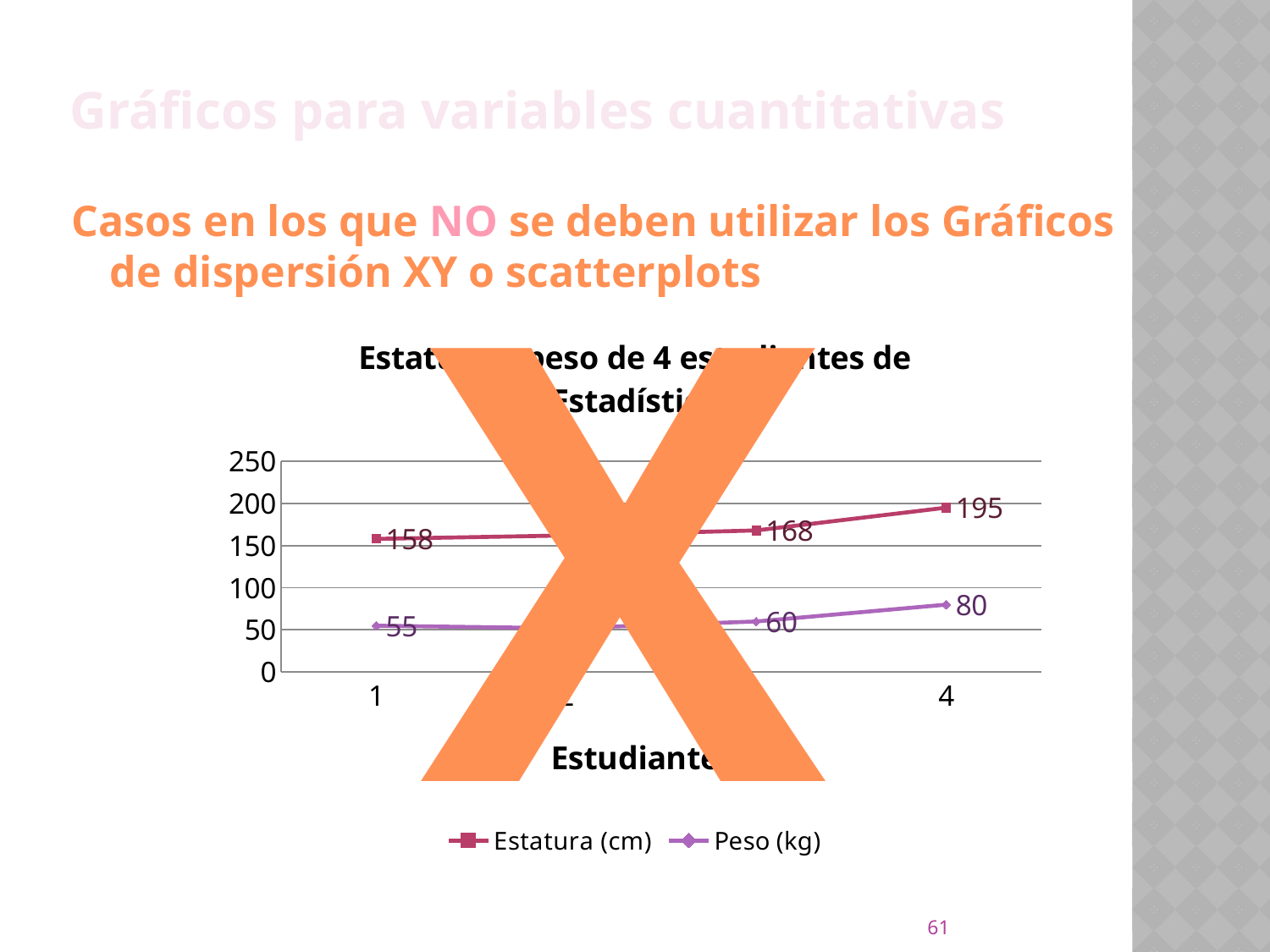
Which student has the highest Estatura (cm) value? 4 What is the Estatura (cm) value for student 4? 195 What is the difference between the Estatura (cm) values for student 4 and student 1? 37 What is the difference between the Peso (kg) values for student 4 and student 1? 25 Which is larger, the Peso (kg) value for student 1 or for student 4? Student 4 What is the Estatura (cm) value for student 1? 158 What is the Peso (kg) value for student 1? 55 Is the Peso (kg) value for student 4 greater or less than 100? less Do the Estatura (cm) values rise or fall from student 1 to student 4? rise What is the Peso (kg) value for student 4? 80 How many series does the legend list? 2